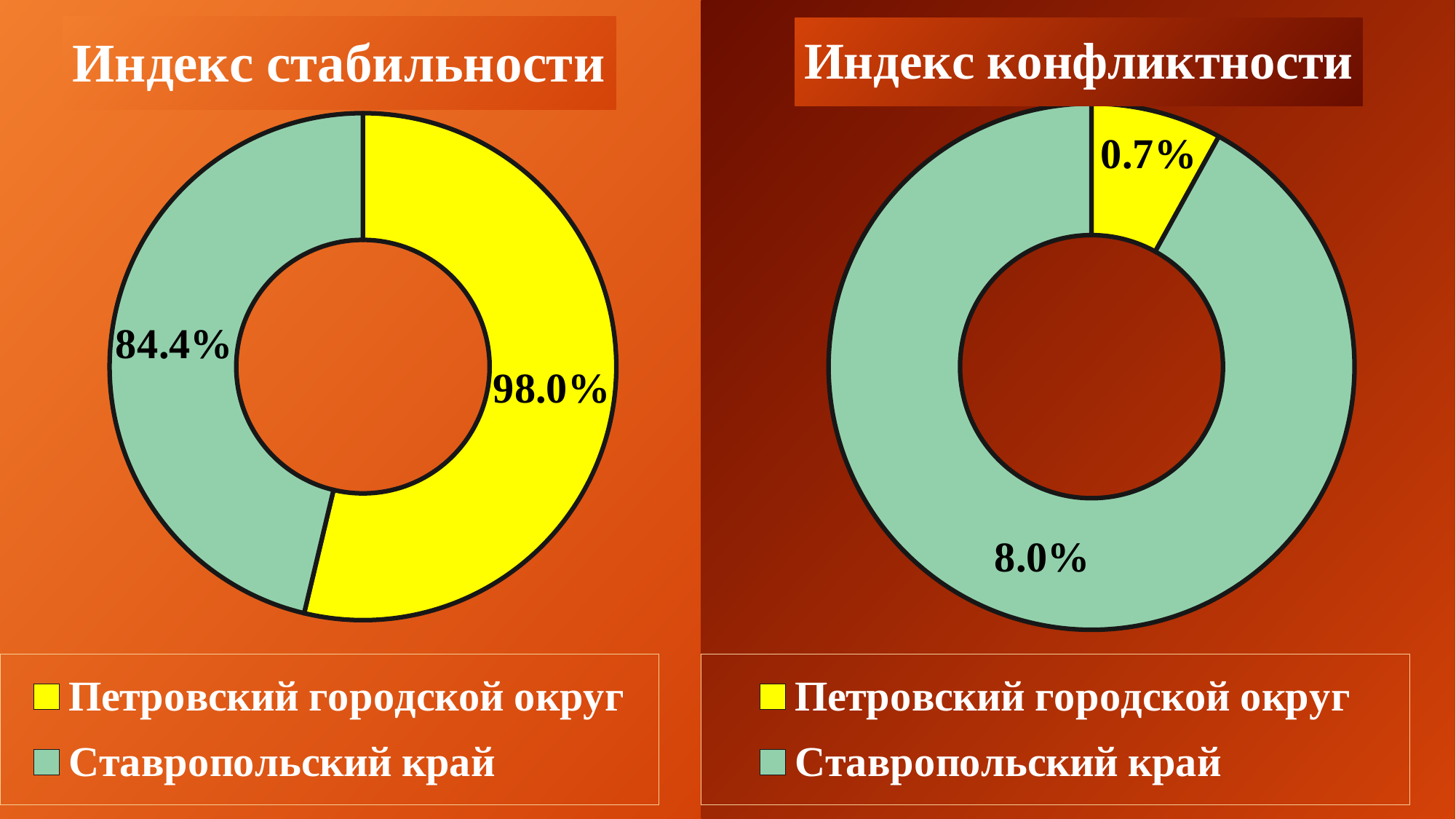
What kind of chart is the chart titled "Индекс конфликтности"? doughnut chart In the chart titled "Индекс стабильности", which colour represents Ставропольский край? green In the chart titled "Индекс конфликтности", what is the value for Ставропольский край? 8.0% In the chart titled "Индекс стабильности", what is the value for Петровский городской округ? 98.0% In the chart titled "Индекс стабильности", what is the difference between the values for Петровский городской округ and Ставропольский край? 13.6% In the chart titled "Индекс стабильности", what is the value for Ставропольский край? 84.4% In the chart titled "Индекс стабильности", which category has the higher value? Петровский городской округ In the chart titled "Индекс конфликтности", what is the difference between the values for Ставропольский край and Петровский городской округ? 7.3% How many categories does the legend of the chart titled "Индекс стабильности" list? 2 In the chart titled "Индекс конфликтности", which category has the lower value? Петровский городской округ In the chart titled "Индекс конфликтности", is the value for Ставропольский край larger or smaller than the value for Петровский городской округ? larger In the chart titled "Индекс конфликтности", what is the value for Петровский городской округ? 0.7%